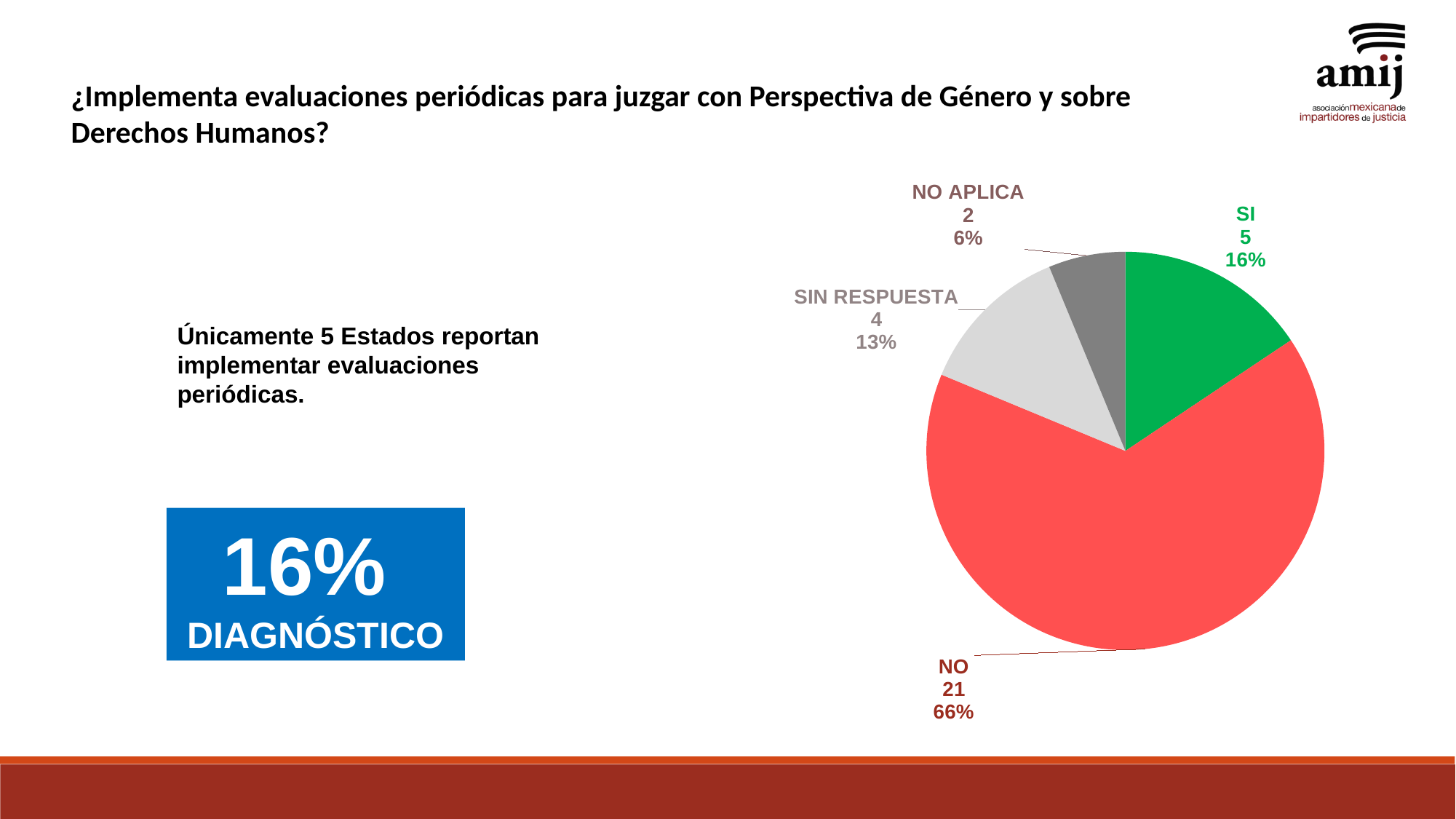
What kind of chart is shown on the slide? pie chart Which is larger, the count for SIN RESPUESTA or the count for NO APLICA? SIN RESPUESTA Which category has the smallest slice? NO APLICA What is the difference between the counts for NO and SI? 16 What is the count for SIN RESPUESTA? 4 What is the count for the NO slice? 21 What colour is the SI slice? green What percentage is shown for NO APLICA? 6% What is the count for the SI slice? 5 What share of the pie does the NO slice represent? 66% Which category has the largest slice? NO How many slices does the pie chart have? 4